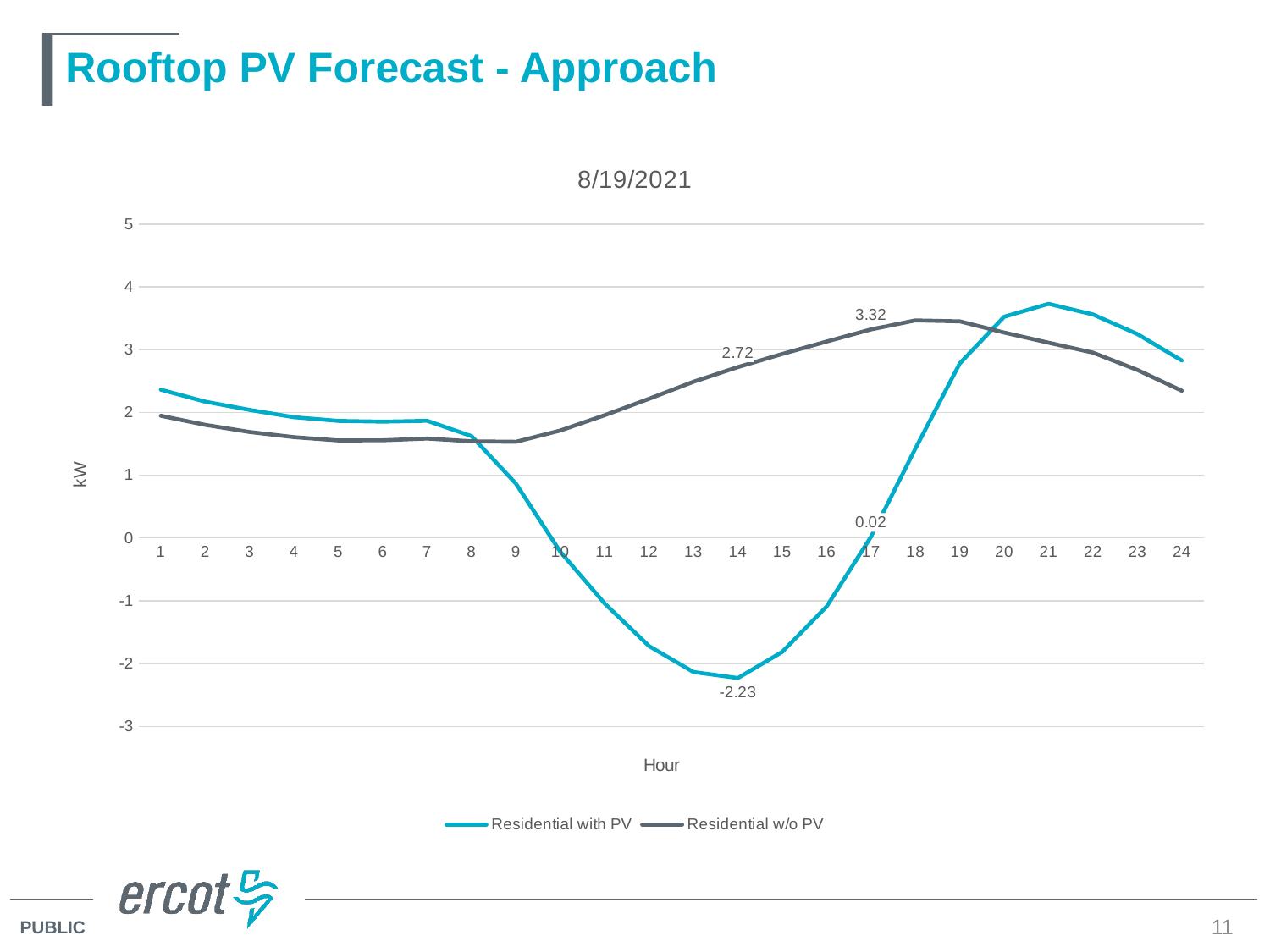
What is the value of Residential with PV at hour 17? 0.02 What is the value of Residential w/o PV at hour 14? 2.72 What is the value of Residential with PV at hour 14? -2.23 What kind of chart is shown on the slide? Line chart At hour 14, how much higher is Residential w/o PV than Residential with PV? 4.95 Is the value for Residential with PV at hour 21 greater or less than 3? greater At which hour does the Residential with PV line reach its lowest value? 14 Is the value for Residential w/o PV at hour 5 greater or less than 2? less At which hour does the Residential with PV line reach its highest value? 21 At hour 17, which series has the larger value, Residential with PV or Residential w/o PV? Residential w/o PV What is the value of Residential w/o PV at hour 17? 3.32 How many series does the legend list? 2